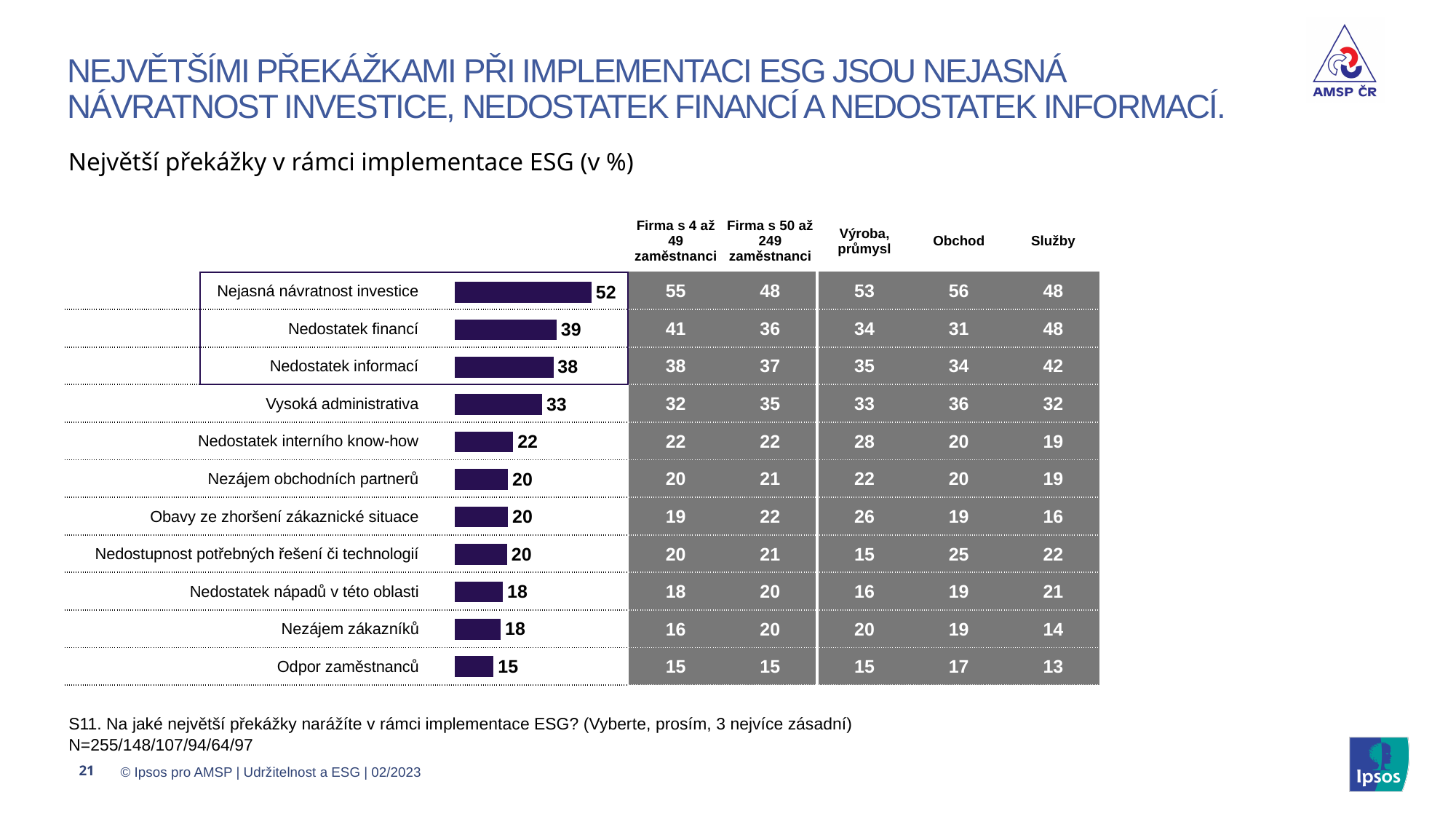
What type of chart is used to show the overall values? Bar chart What is the difference between the values for "Nejasná návratnost investice" and "Nedostatek financí"? 13 In the table next to the chart, what is the value for "Nedostatek financí" in the "Služby" column? 48 Which has a larger value, "Nedostatek financí" or "Vysoká administrativa"? Nedostatek financí What is the value shown for "Nejasná návratnost investice" in the bar chart? 52 What is the value shown for "Nedostatek interního know-how" in the bar chart? 22 What is the title of the chart? Největší překážky v rámci implementace ESG (v %) What is the value shown for "Vysoká administrativa" in the bar chart? 33 What is the difference between the values for "Vysoká administrativa" and "Odpor zaměstnanců"? 18 Which category has the highest value in the bar chart? Nejasná návratnost investice Which category has the lowest value in the bar chart? Odpor zaměstnanců How many categories are shown in the bar chart? 11